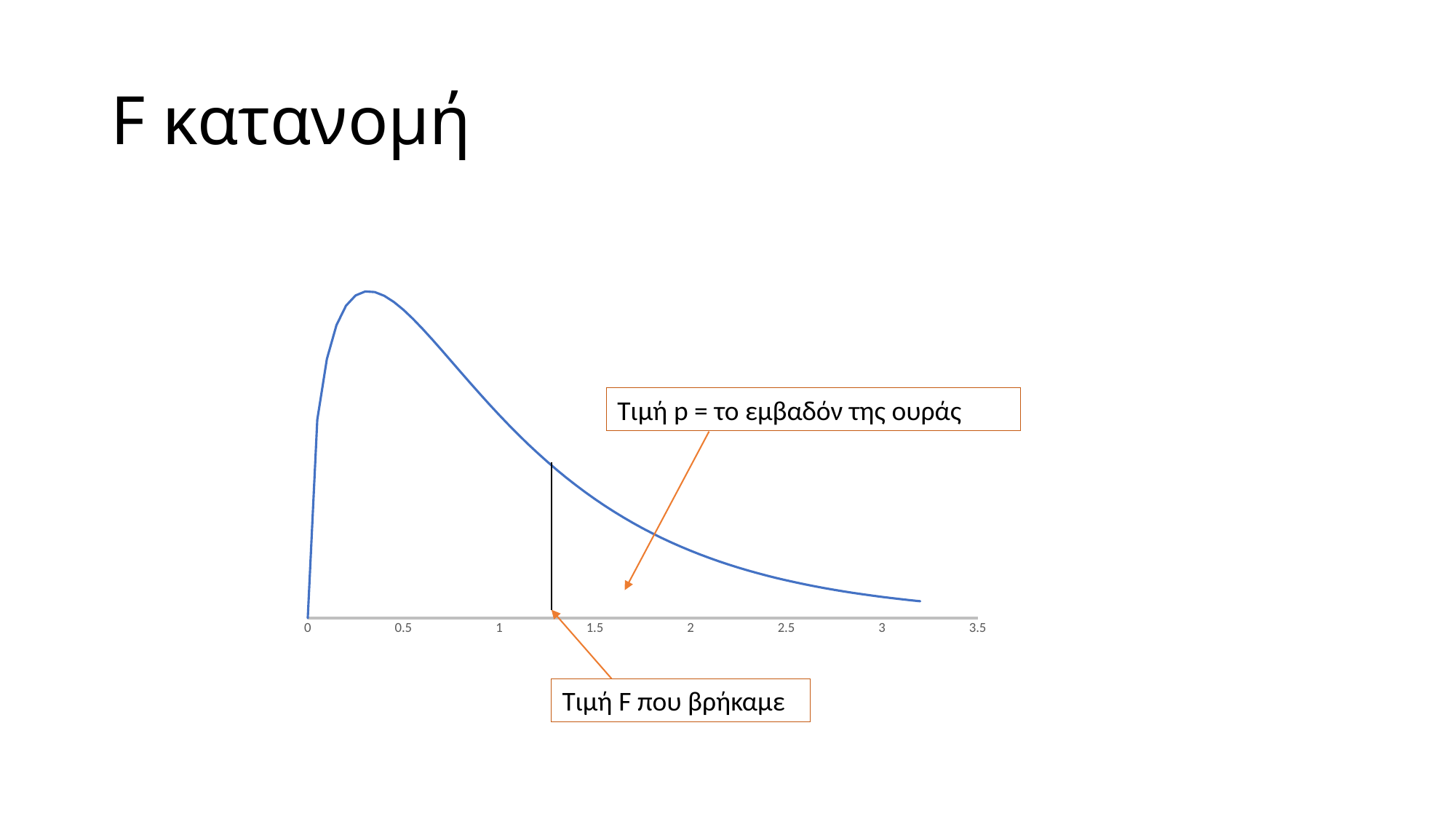
Is the x position of the vertical black line (the F value found) greater or less than 1? greater Is the x position of the curve's peak greater or less than 0.5? less Is the x value where the curve ends on the right greater or less than 3? greater How many series are plotted on the chart? 1 What kind of chart is shown on the slide? line chart What is the smallest tick label shown on the x axis? 0 What is the largest tick label shown on the x axis? 3.5 What does the annotation pointing to the tail area of the curve say? Τιμή p = το εμβαδόν της ουράς What is the title of the slide containing the chart? F κατανομή How many tick labels are shown on the x axis of the chart? 8 After the curve reaches its peak, does it rise or fall as x increases? fall